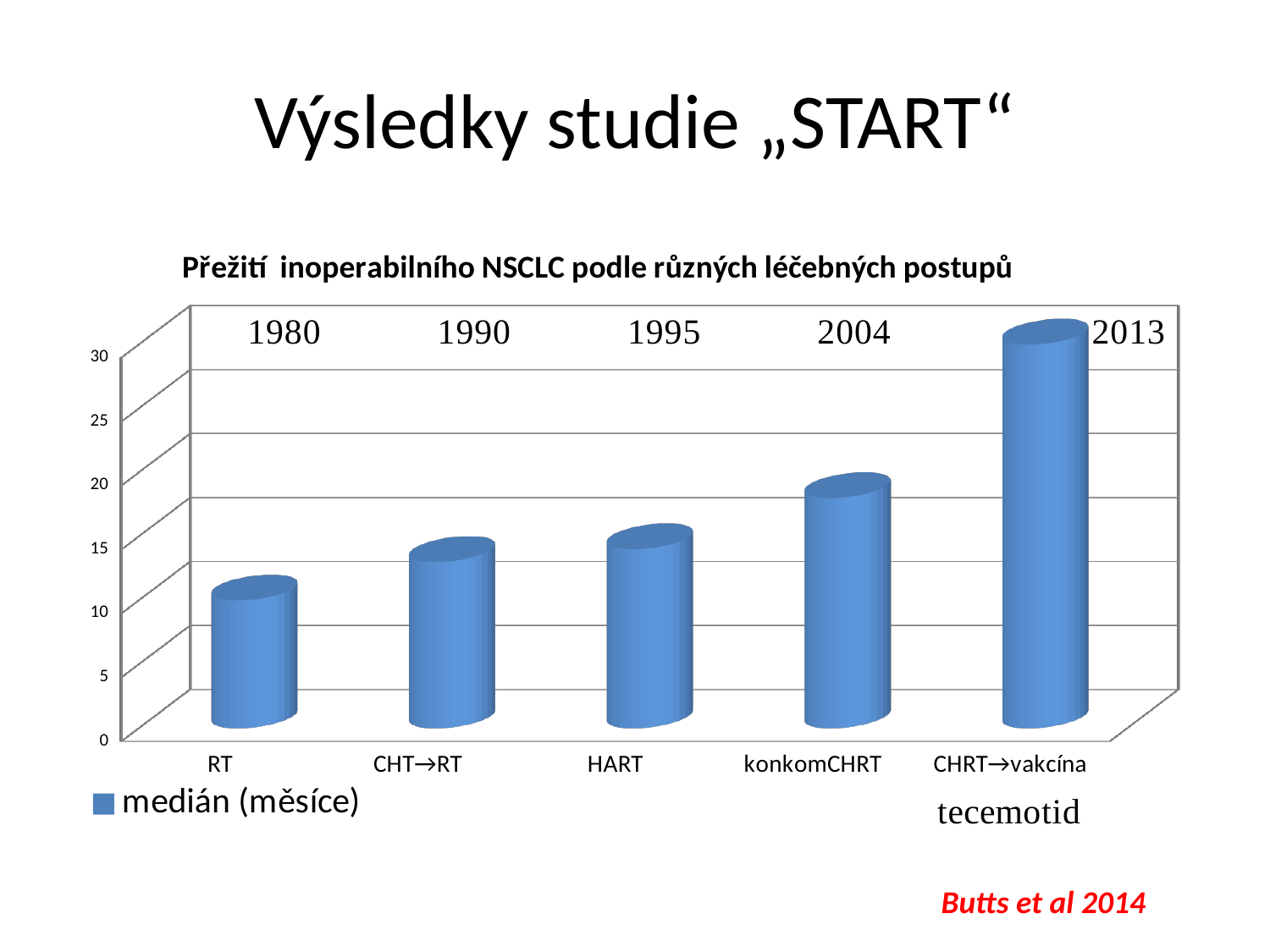
Which is larger, the value for konkomCHRT or the value for HART? konkomCHRT How many categories are shown on the x axis of the chart? 5 How many series does the chart legend list? 1 What is the legend entry of the series plotted in the chart? medián (měsíce) Do the values rise or fall from left to right along the x axis? rise What kind of chart is shown on the slide? bar chart What is the title of the chart? Přežití inoperabilního NSCLC podle různých léčebných postupů Which category has the lowest value in the chart? RT Is the value for CHRT→vakcína greater or less than 25? greater Is the value for RT greater or less than 15? less Is the value for konkomCHRT greater or less than 15? greater Which category has the highest value in the chart? CHRT→vakcína